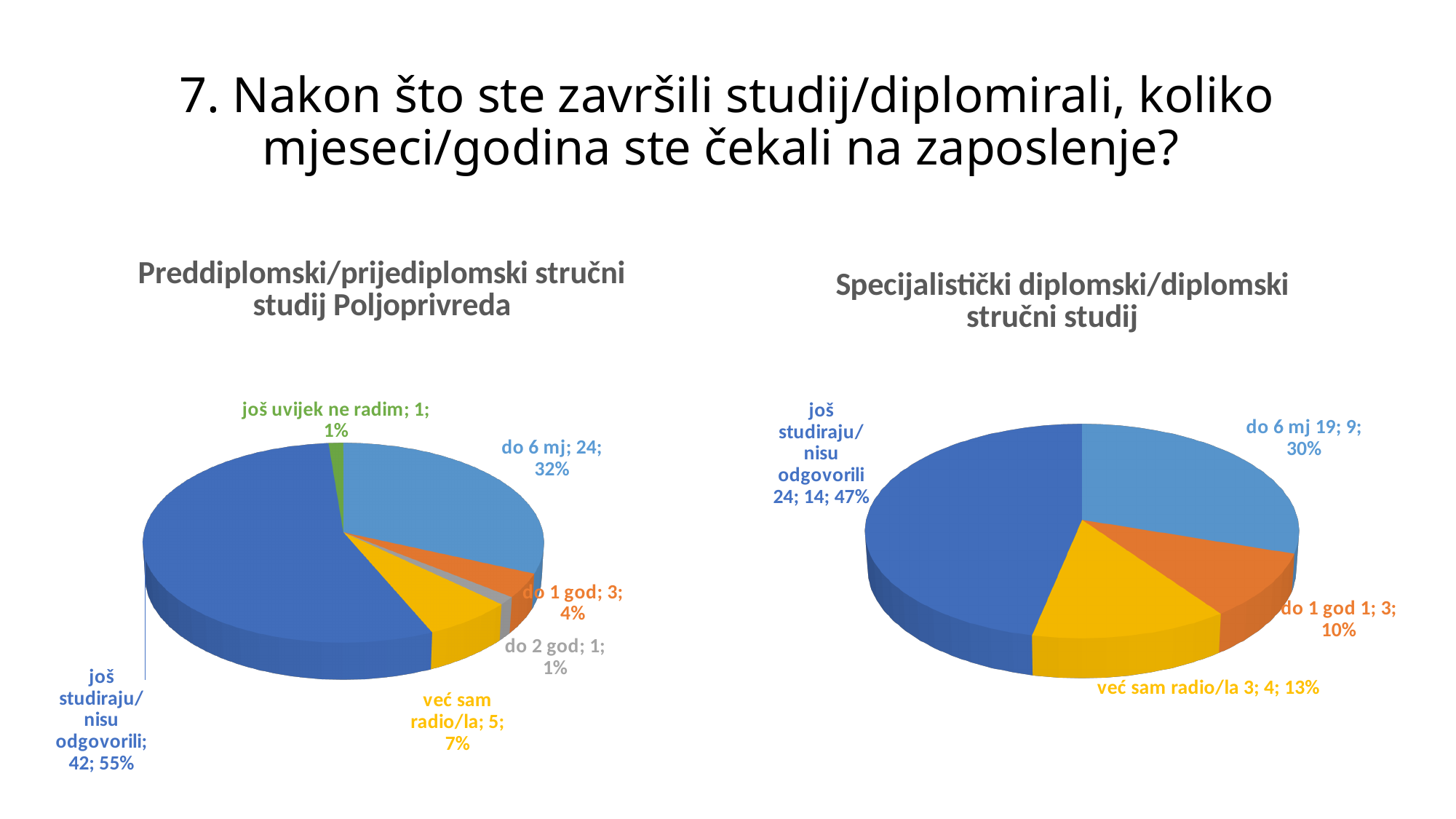
In the right chart (Specijalistički diplomski/diplomski stručni studij), which category has the smallest slice? do 1 god In the left chart (Preddiplomski/prijediplomski stručni studij Poljoprivreda), what share of the pie is 'još studiraju/nisu odgovorili'? 55% In the left chart (Preddiplomski/prijediplomski stručni studij Poljoprivreda), which is larger: the count for 'do 1 god' or for 'do 2 god'? do 1 god In the right chart (Specijalistički diplomski/diplomski stručni studij), what is the difference between the counts for 'još studiraju/nisu odgovorili' and 'do 6 mj'? 5 In the left chart (Preddiplomski/prijediplomski stručni studij Poljoprivreda), what is the difference between the counts for 'do 6 mj' and 'već sam radio/la'? 19 In the right chart (Specijalistički diplomski/diplomski stručni studij), how many slices does the pie have? 4 In the left chart (Preddiplomski/prijediplomski stručni studij Poljoprivreda), how many slices does the pie have? 6 In the right chart (Specijalistički diplomski/diplomski stručni studij), what share of the pie is 'do 6 mj'? 30% In the left chart (Preddiplomski/prijediplomski stručni studij Poljoprivreda), what is the count for 'do 6 mj'? 24 In the left chart (Preddiplomski/prijediplomski stručni studij Poljoprivreda), which category has the largest slice? još studiraju/nisu odgovorili What type of chart is used on the left chart titled 'Preddiplomski/prijediplomski stručni studij Poljoprivreda'? Pie chart In the right chart (Specijalistički diplomski/diplomski stručni studij), what is the count for 'već sam radio/la'? 4